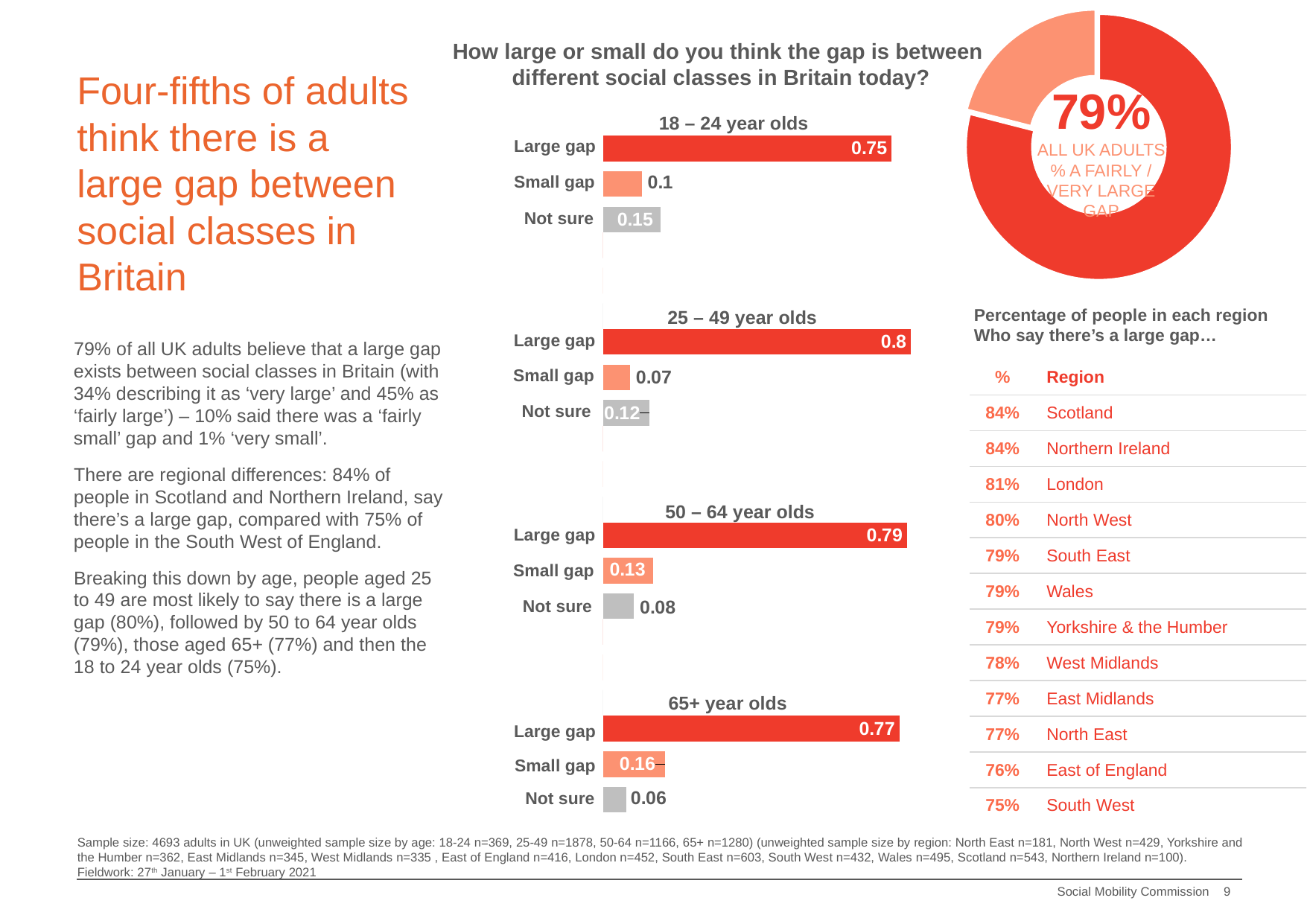
How many categories does the 18 – 24 year olds bar chart show? 3 In the 18 – 24 year olds bar chart, which category has the lowest value? Small gap What percentage is shown in the centre of the donut chart at the top right of the slide? 79% In the 25 – 49 year olds bar chart, what is the value for Small gap? 0.07 What kind of chart is used for the 25 – 49 year olds data? Bar chart In the 65+ year olds bar chart, what is the value for Small gap? 0.16 In the 18 – 24 year olds bar chart, what is the value for Large gap? 0.75 In the 25 – 49 year olds bar chart, what is the difference between the Large gap and Not sure values? 0.68 In the 65+ year olds bar chart, which category has the highest value? Large gap In the 50 – 64 year olds bar chart, what is the value for Not sure? 0.08 What is the title of the set of bar charts in the middle of the slide? How large or small do you think the gap is between different social classes in Britain today? In the 50 – 64 year olds bar chart, which is larger, Small gap or Not sure? Small gap